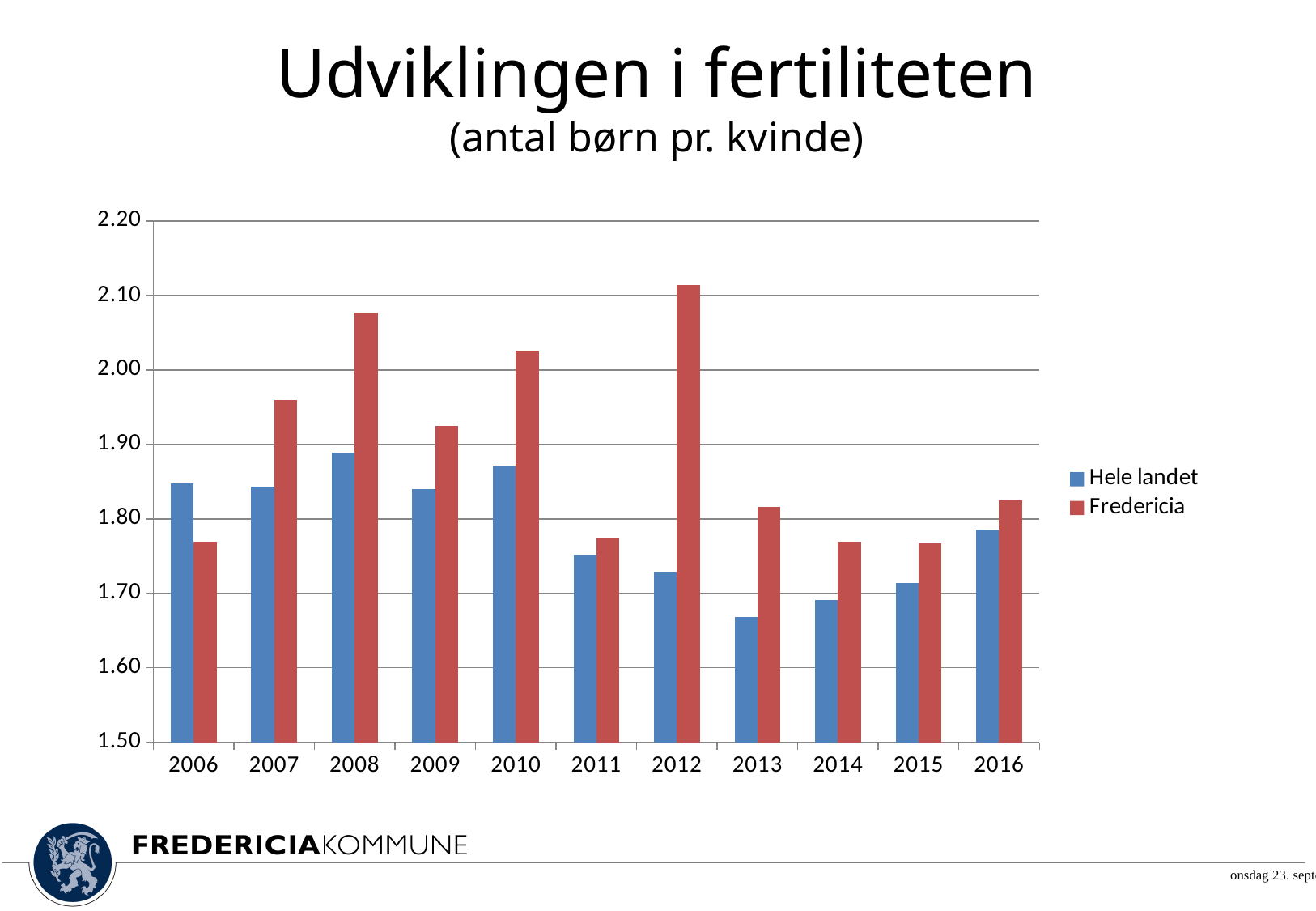
Does the Hele landet value rise or fall from 2010 to 2013? fall In which year is the Hele landet value highest? 2008 What kind of chart is shown on the slide? Bar chart In 2012, which series has the larger value, Hele landet or Fredericia? Fredericia How many years are shown on the x axis? 11 In 2006, which series has the larger value, Hele landet or Fredericia? Hele landet In which year is the Hele landet value lowest? 2013 How many series does the legend list? 2 Is the Hele landet value for 2013 greater or less than 1.70? less Is the Fredericia value for 2008 greater or less than 2.00? greater In which year is the Fredericia value highest? 2012 Which colour represents Fredericia in the legend? Red